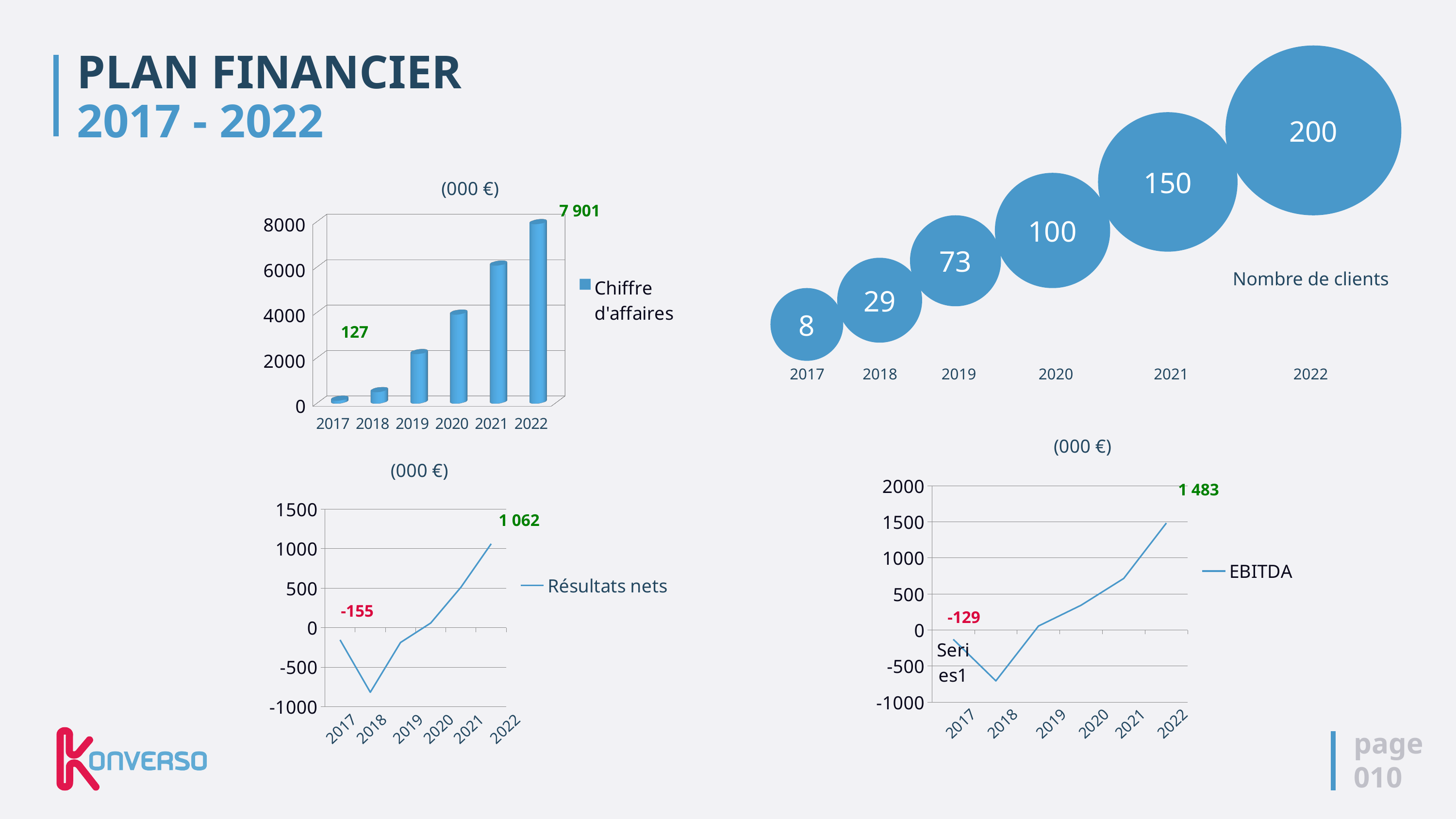
How many years are shown in the Nombre de clients chart? 6 In the Chiffre d'affaires chart, is the value for 2021 greater or less than 4000? greater In the Chiffre d'affaires chart, which year has the highest value? 2022 In the Chiffre d'affaires bar chart, what is the value for 2022? 7 901 In the Résultats nets chart, what is the value for 2017? -155 In the Résultats nets chart, which year has the lowest value? 2018 What kind of chart is the Chiffre d'affaires chart? bar chart In the Nombre de clients chart, what is the difference between 2022 and 2021? 50 In the Chiffre d'affaires bar chart, what is the value for 2017? 127 In the EBITDA chart, is the value for 2021 greater or less than 500? greater In the EBITDA chart, what is the value for 2022? 1 483 In the Nombre de clients chart, what is the value for 2019? 73